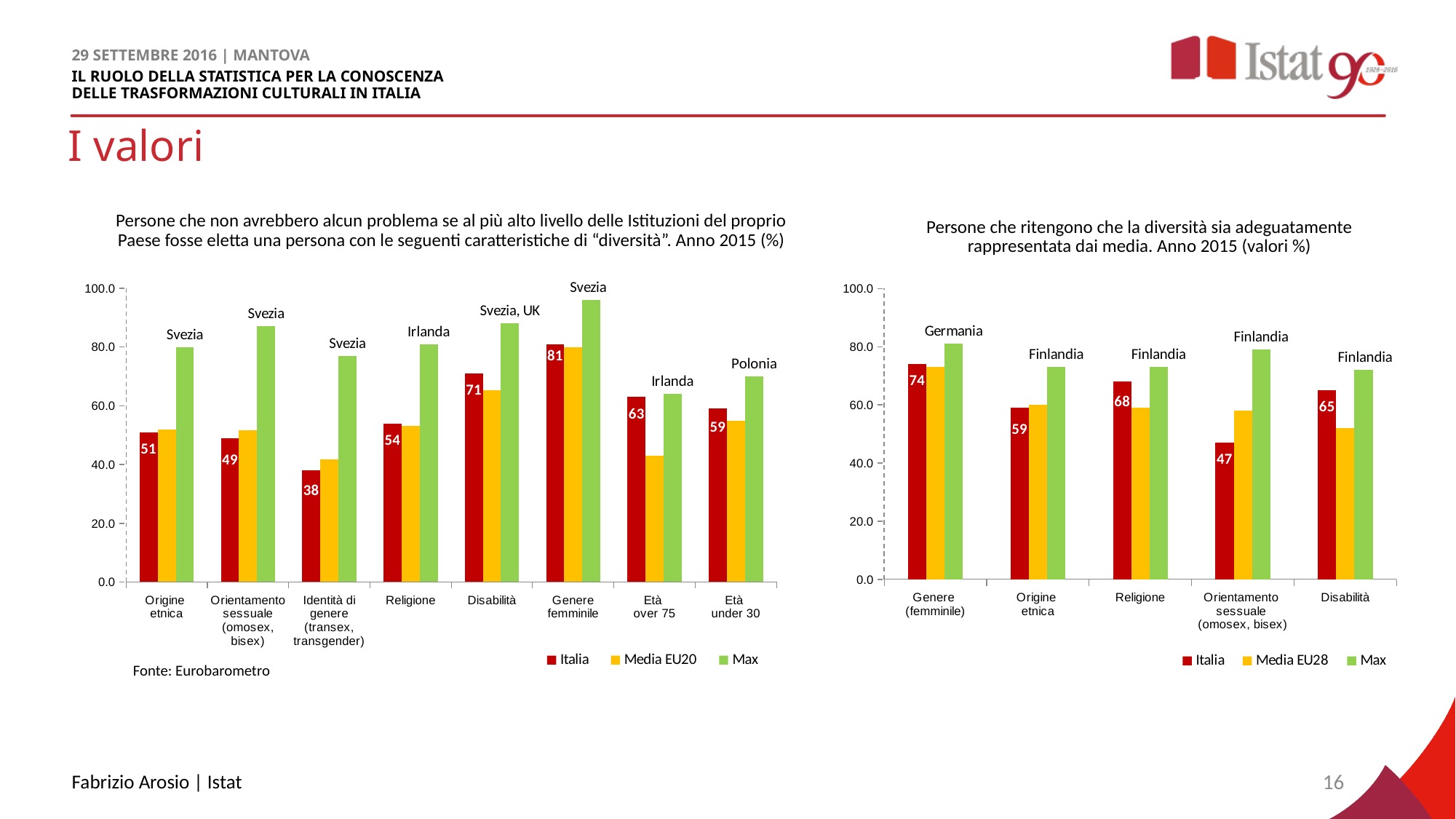
In the left chart, what is the difference between the Italia values for Disabilità and Religione? 17 In the left chart, which category has the lowest Italia value? Identità di genere (transex, transgender) In the left chart, what is the value for Italia for Identità di genere (transex, transgender)? 38 In the left chart, which country is labelled as the Max for Religione? Irlanda In the left chart, how many categories are shown on the x axis? 8 In the left chart, which category has the highest Italia value? Genere femminile In the right chart, is the Italia value for Religione larger or smaller than the Italia value for Disabilità? larger In the left chart, what is the value for Italia for Genere femminile? 81 In the right chart, what is the value for Italia for Orientamento sessuale (omosex, bisex)? 47 In the left chart, is the Max value for Genere femminile greater or less than 80? greater In the right chart, how many series does the legend list? 3 In the right chart, which category has the highest Italia value? Genere (femminile)